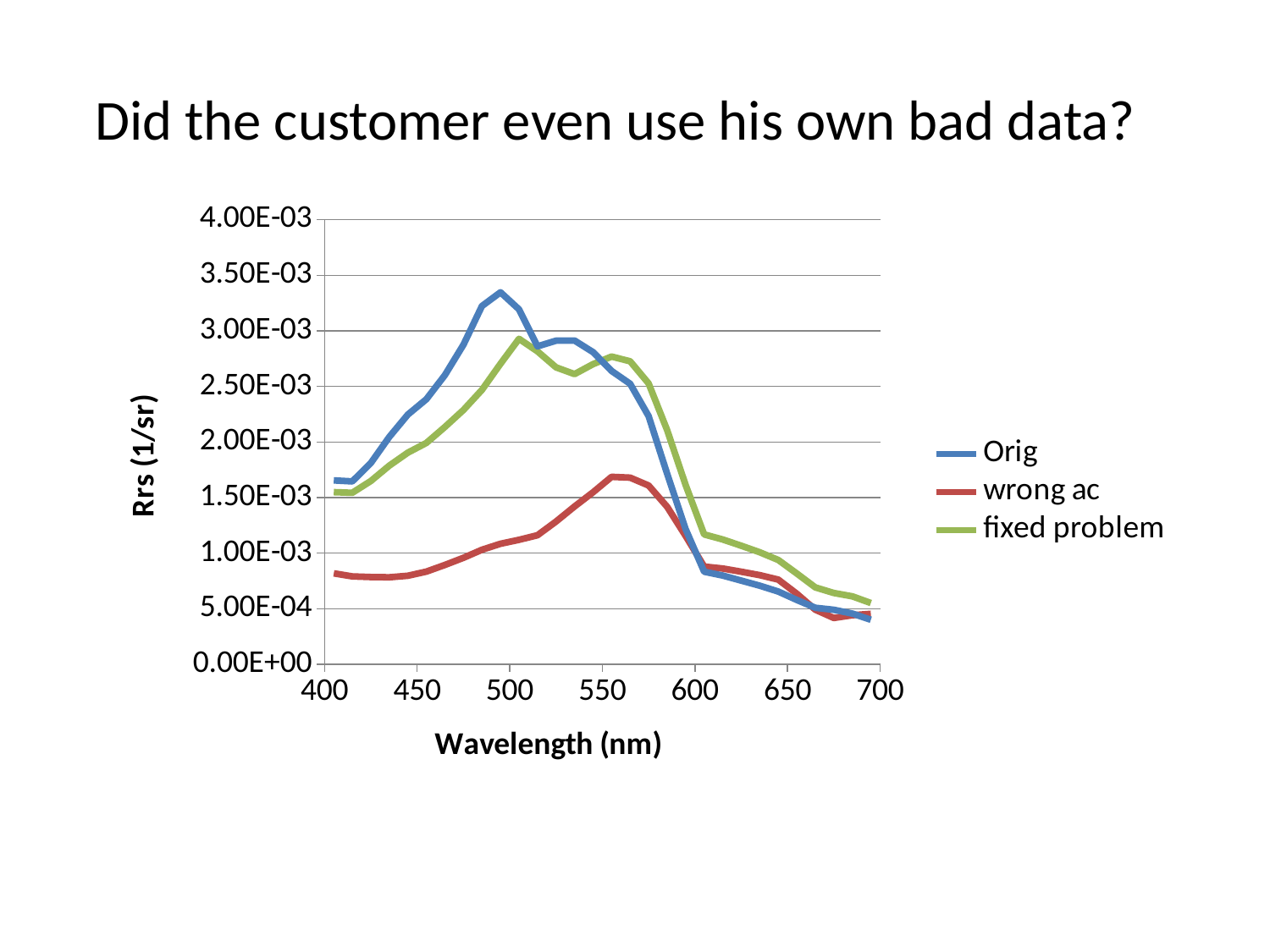
Does the Orig series rise or fall between 600 nm and 700 nm? fall What kind of chart is shown on the slide? line chart What are the names of the series in the legend? Orig, wrong ac, fixed problem Is the value of the fixed problem series at 500 nm greater or less than 2.50E-03? greater Is the value of the Orig series at 500 nm greater or less than 3.00E-03? greater What is the title of the y axis? Rrs (1/sr) How many series does the legend list? 3 Is the value of the wrong ac series at 450 nm greater or less than 1.00E-03? less Which series has the lowest values around 500 nm? wrong ac At 620 nm, which series has the larger value, fixed problem or Orig? fixed problem At 500 nm, which series has the larger value, Orig or wrong ac? Orig Which series reaches the highest peak value? Orig